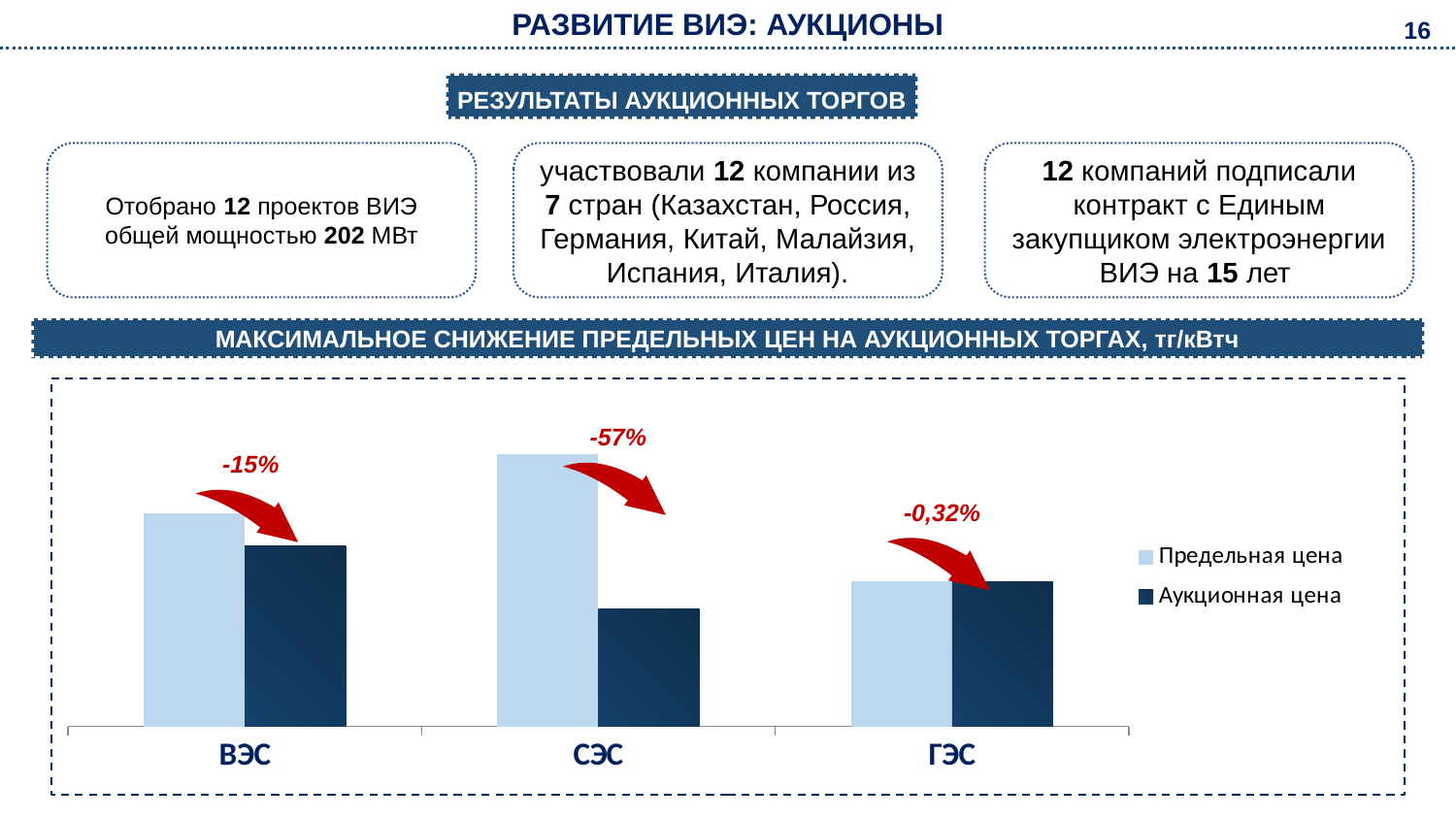
Which category has the highest Предельная цена bar? СЭС What percentage reduction is shown above the bars for ВЭС? -15% What percentage reduction is shown above the bars for СЭС? -57% Which category has the lowest Аукционная цена bar? СЭС What percentage reduction is shown above the bars for ГЭС? -0,32% What are the two series named in the chart legend? Предельная цена, Аукционная цена Which category has the lowest Предельная цена bar? ГЭС For СЭС, which is larger: Предельная цена or Аукционная цена? Предельная цена How many categories are shown on the x axis of the chart? 3 How many series does the chart legend list? 2 What is the title of the chart? МАКСИМАЛЬНОЕ СНИЖЕНИЕ ПРЕДЕЛЬНЫХ ЦЕН НА АУКЦИОННЫХ ТОРГАХ, тг/кВтч What kind of chart is shown on the slide? Bar chart